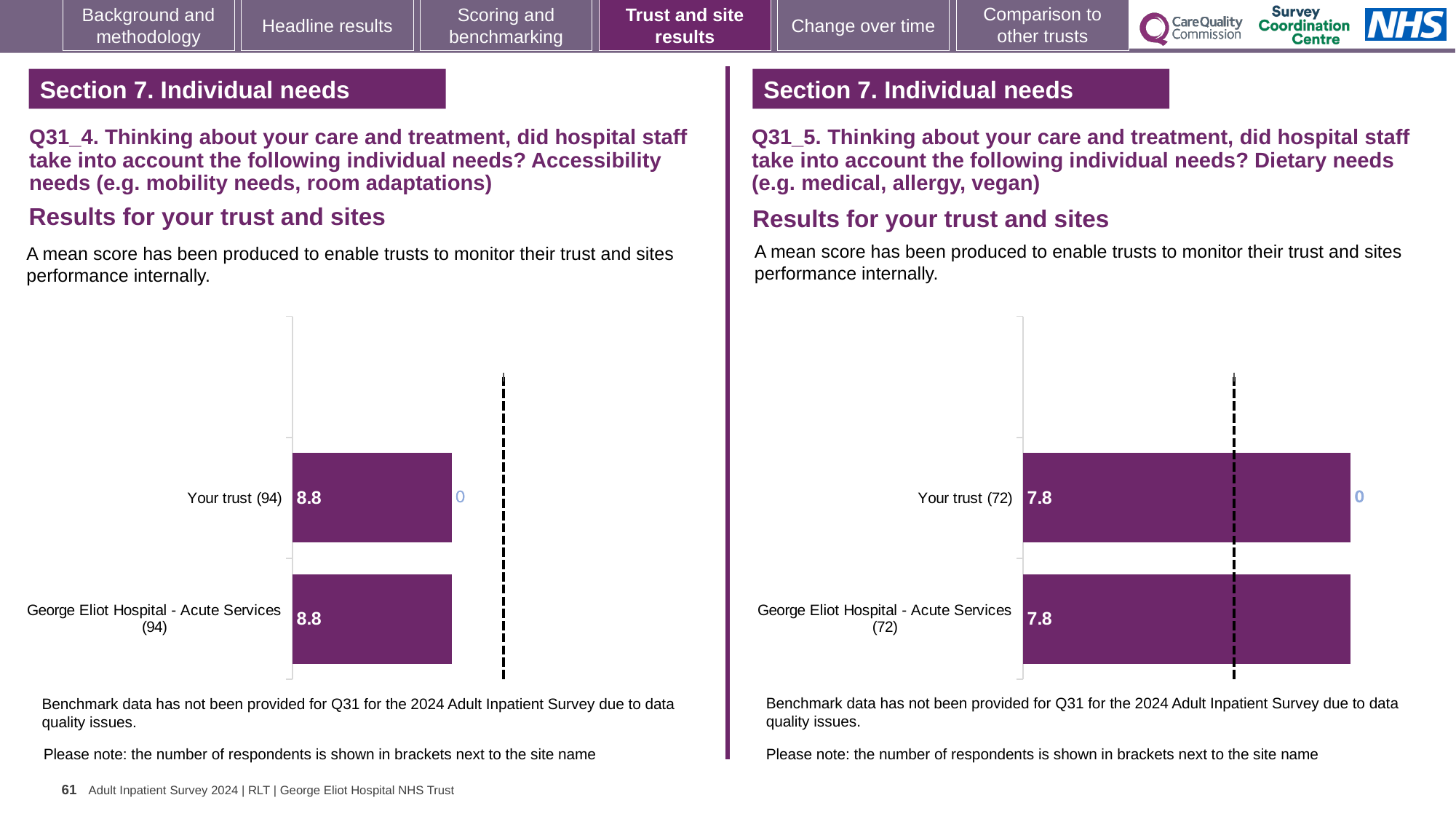
On the right chart (Q31_5, dietary needs), what is the mean score for Your trust? 7.8 On the right chart (Q31_5, dietary needs), what is the mean score for George Eliot Hospital - Acute Services? 7.8 What type of chart is used on the left (Q31_4, accessibility needs)? Bar chart How many bars are plotted on the right chart (Q31_5, dietary needs)? 2 What is the difference between the Your trust score on the left chart (Q31_4) and the Your trust score on the right chart (Q31_5)? 1.0 On the left chart (Q31_4, accessibility needs), what is the mean score for George Eliot Hospital - Acute Services? 8.8 On the right chart (Q31_5, dietary needs), how many respondents are shown in brackets next to Your trust? 72 On the left chart (Q31_4, accessibility needs), what is the mean score for Your trust? 8.8 On the left chart (Q31_4, accessibility needs), how many respondents are shown in brackets next to George Eliot Hospital - Acute Services? 94 Which is larger: the Your trust score on the left chart (Q31_4) or the Your trust score on the right chart (Q31_5)? Left chart (Q31_4), 8.8 How many bars are plotted on the left chart (Q31_4, accessibility needs)? 2 On the left chart (Q31_4, accessibility needs), is the score for Your trust higher or lower than the score for George Eliot Hospital - Acute Services, or are they the same? The same